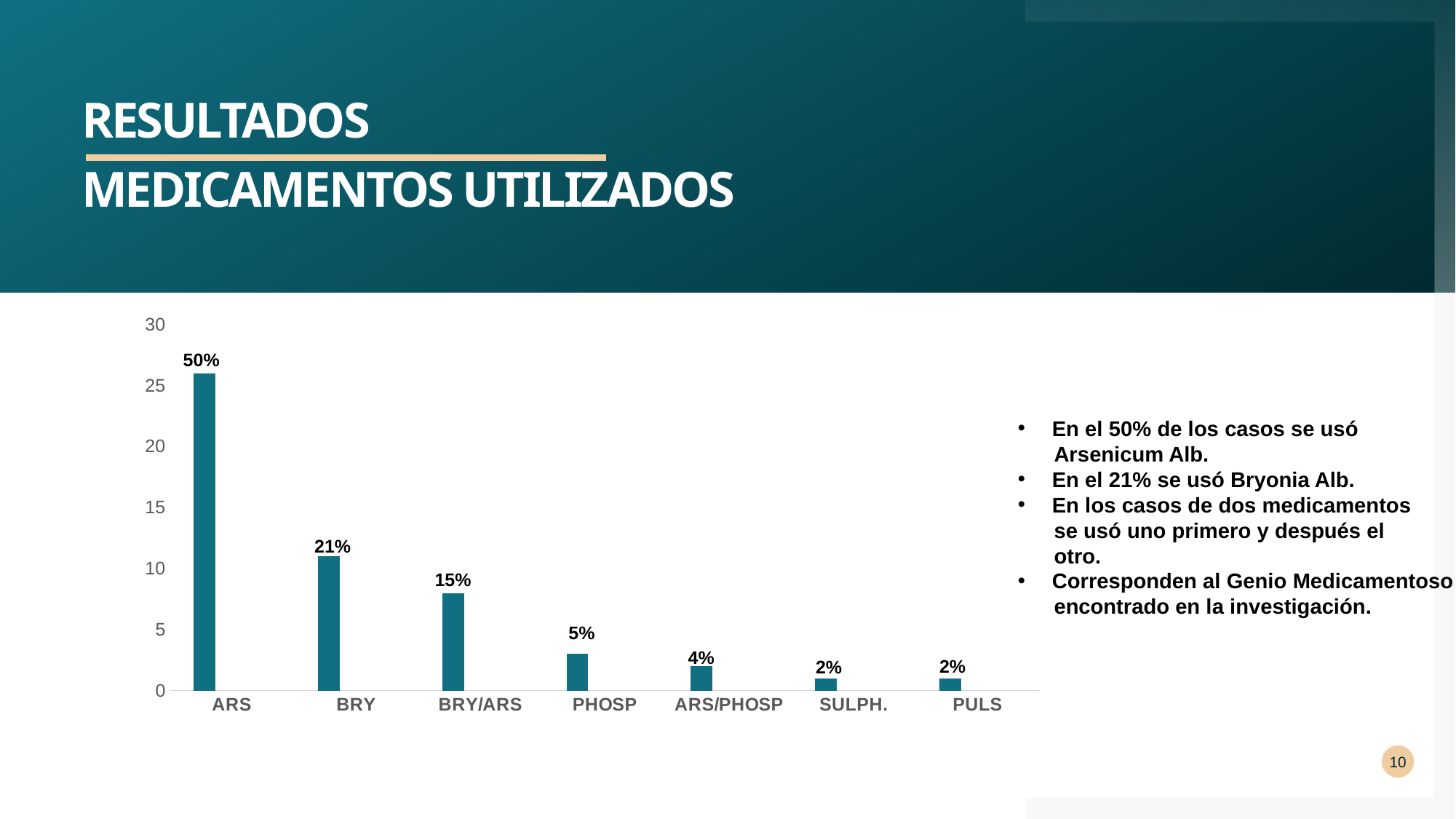
What is the difference between the data labels for ARS and BRY? 29% Is the bar for ARS greater or less than 20 on the vertical axis? greater Which category has the highest value? ARS What is the data label shown for ARS? 50% Do the values rise or fall from left to right along the x axis? fall How many categories are shown on the x axis? 7 What kind of chart is shown on the slide? bar chart What is the data label shown for PHOSP? 5% What is the data label shown for BRY? 21% What is the data label shown for ARS/PHOSP? 4% Which has a larger value, BRY/ARS or PHOSP? BRY/ARS What is the data label shown for BRY/ARS? 15%